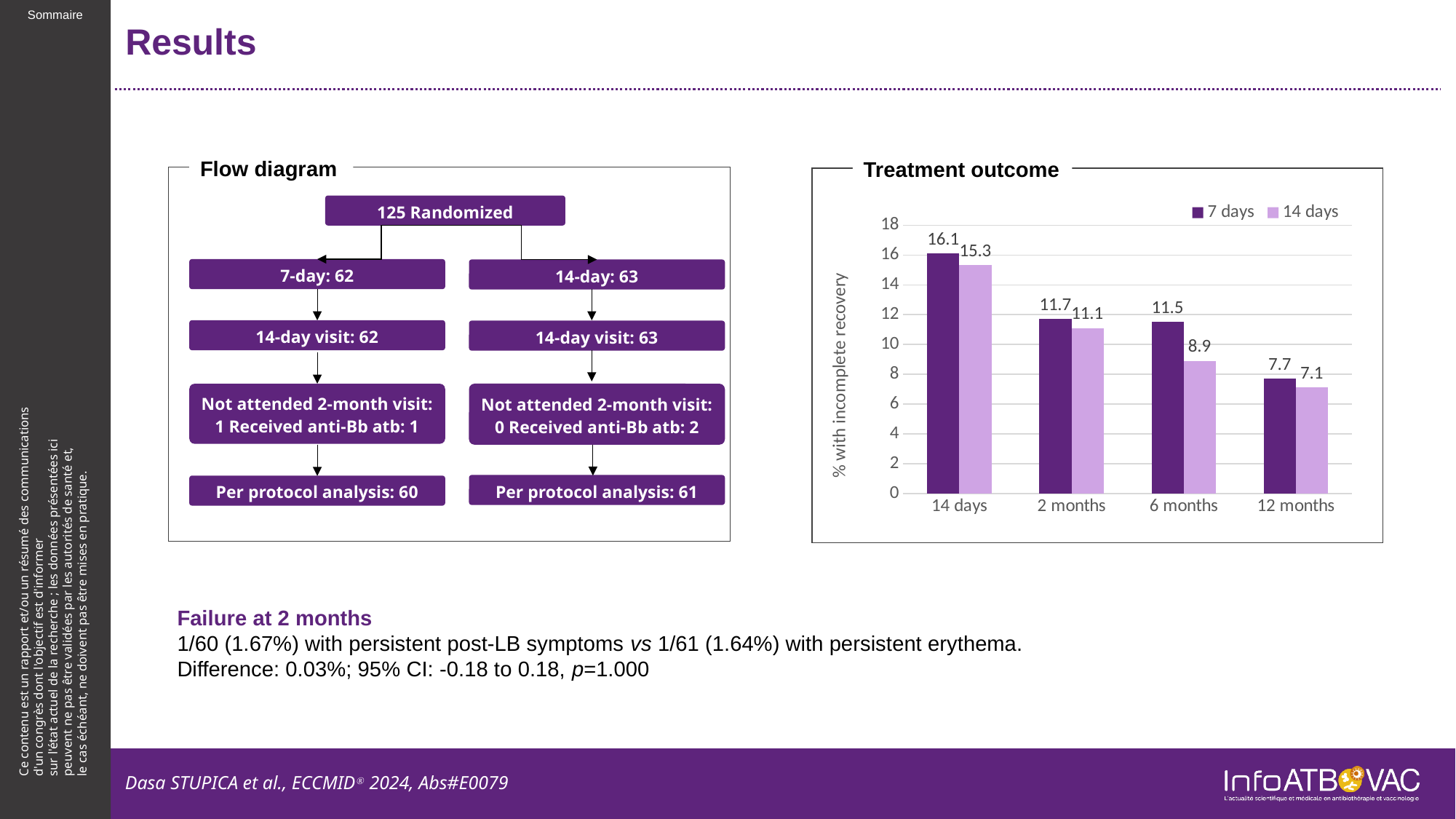
What kind of chart is the Treatment outcome chart? bar chart In the Treatment outcome chart, which time point has the highest value for the 7 days series? 14 days In the Treatment outcome chart, do the 7 days values rise or fall from 14 days to 12 months? fall In the Treatment outcome chart, which is larger at 2 months: the 7 days value or the 14 days value? 7 days In the Treatment outcome chart, what is the difference between the 7 days and 14 days values at 6 months? 2.6 In the Treatment outcome chart, what is the value for 7 days at 14 days? 16.1 In the Treatment outcome chart, what is the value for 14 days at 6 months? 8.9 In the Treatment outcome chart, what is the value for 14 days at 12 months? 7.1 How many time points are shown on the x axis of the Treatment outcome chart? 4 How many series does the legend of the Treatment outcome chart list? 2 In the Treatment outcome chart, which time point has the lowest value for the 14 days series? 12 months In the Treatment outcome chart, is the value for 7 days at 12 months greater or less than 8? less